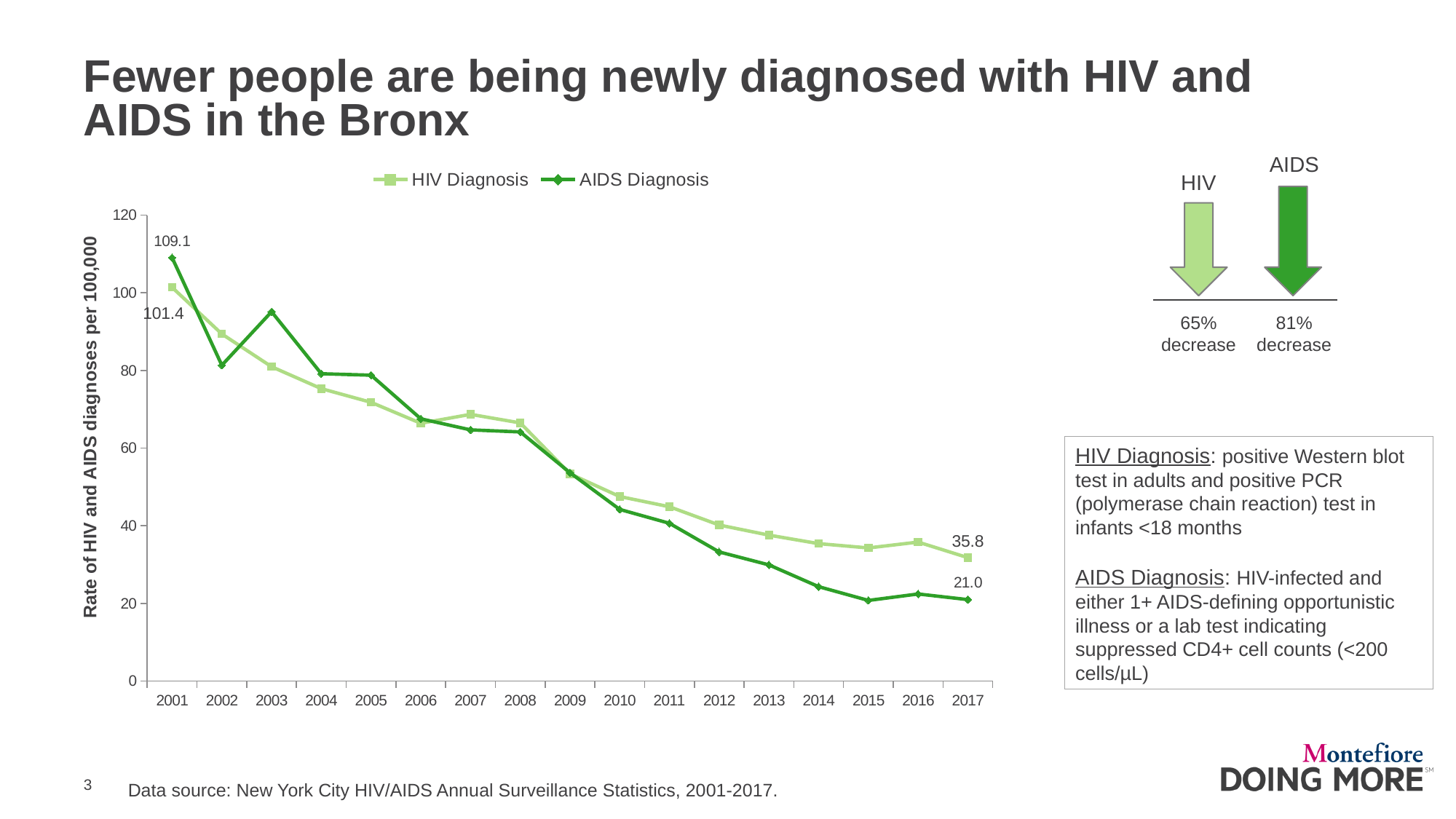
In 2001, which series has the higher rate, HIV Diagnosis or AIDS Diagnosis? AIDS Diagnosis What type of chart is shown on the slide? line chart What is the AIDS Diagnosis rate in 2001? 109.1 By how much did the AIDS Diagnosis rate fall from 2001 to 2017? 88.1 What value is labelled at the 2017 end of the HIV Diagnosis line? 35.8 Do the HIV and AIDS diagnosis rates generally rise or fall from 2001 to 2017? fall How many series does the legend list? 2 What is the AIDS Diagnosis rate in 2017? 21.0 What is the HIV Diagnosis rate in 2001? 101.4 Is the AIDS Diagnosis rate in 2003 greater or less than 80? greater According to the arrows on the right, what is the percentage decrease in AIDS diagnoses? 81% decrease How many years are shown on the x axis of the chart? 17